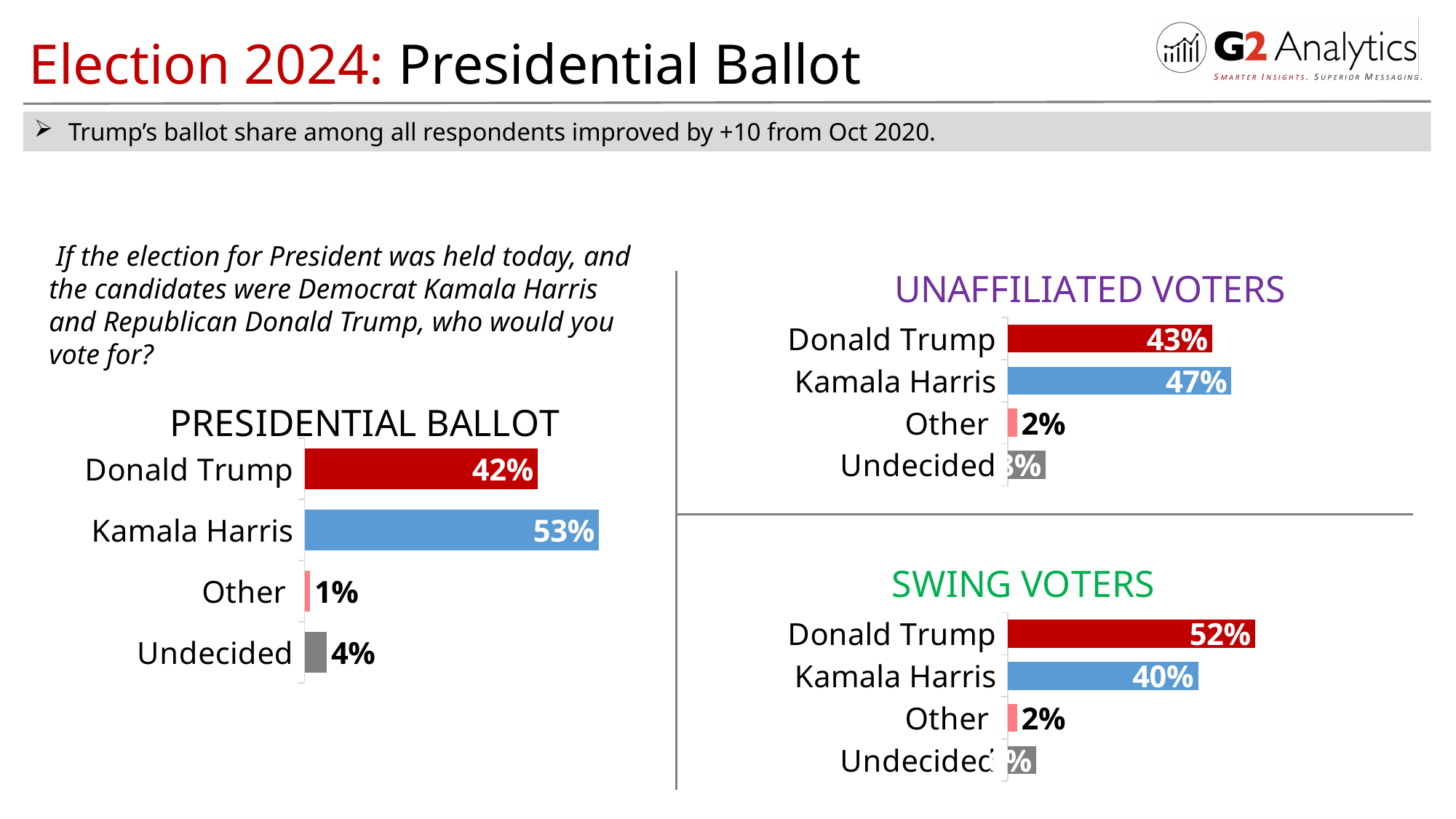
How many categories does the Swing Voters chart show? 4 In the Presidential Ballot chart, what percentage is shown for Donald Trump? 42% In the Swing Voters chart, which is larger, Donald Trump or Kamala Harris? Donald Trump In the Presidential Ballot chart, what is the difference between Kamala Harris and Donald Trump? 11% In the Presidential Ballot chart, which category has the lowest value? Other In the Unaffiliated Voters chart, what is the difference between Kamala Harris and Donald Trump? 4% In the Presidential Ballot chart, what percentage is shown for Undecided? 4% In the Swing Voters chart, what percentage is shown for Kamala Harris? 40% In the Presidential Ballot chart, which category has the highest value? Kamala Harris In the Unaffiliated Voters chart, what percentage is shown for Kamala Harris? 47% In the Presidential Ballot chart, what percentage is shown for Kamala Harris? 53% In the Unaffiliated Voters chart, what percentage is shown for Donald Trump? 43%